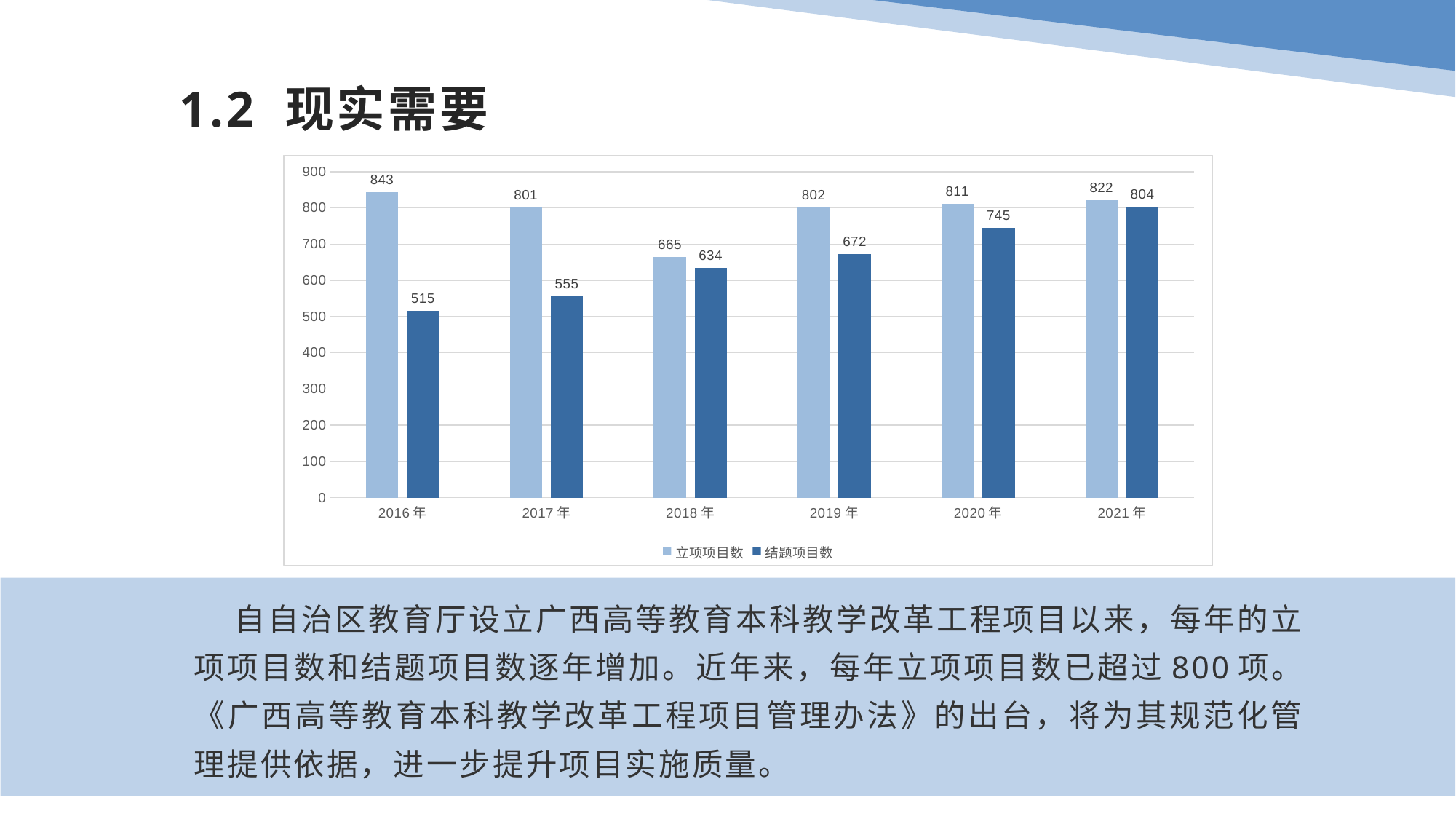
How many years are shown on the x axis? 6 Which year has the highest 结题项目数? 2021年 Does 结题项目数 rise or fall from 2016年 to 2021年? rise How many series does the legend list? 2 Is the value of 结题项目数 for 2017年 greater or less than 600? less What kind of chart is shown on the slide? bar chart What is the value of 立项项目数 for 2016年? 843 Which is larger in 2020年, 立项项目数 or 结题项目数? 立项项目数 Which series is shown in the darker blue colour? 结题项目数 What is the difference between 立项项目数 and 结题项目数 in 2016年? 328 Which year has the lowest 立项项目数? 2018年 What is the value of 结题项目数 for 2019年? 672